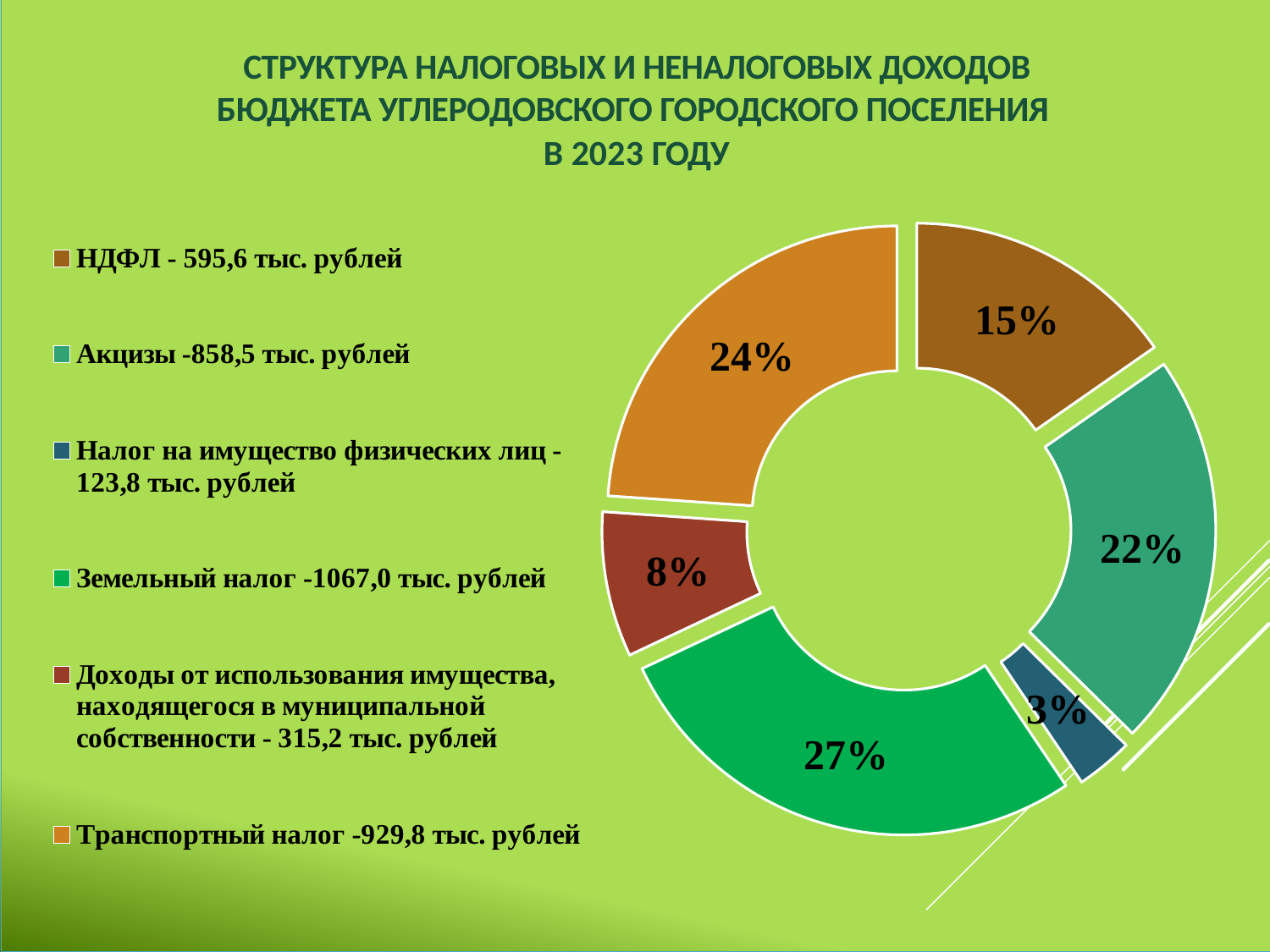
What share of the chart does Акцизы represent? 22% What share of the chart does Земельный налог represent? 27% What share of the chart does Транспортный налог represent? 24% Which category has the smallest share of the chart? Налог на имущество физических лиц Which category has the largest share of the chart? Земельный налог Which has a larger share: Акцизы or НДФЛ? Акцизы What is the difference in percentage points between the shares of Земельный налог and Транспортный налог? 3 percentage points According to the legend, what is the amount for Земельный налог? 1067,0 тыс. рублей What colour is the slice for Доходы от использования имущества, находящегося в муниципальной собственности? Red-brown What kind of chart is shown on the slide? Doughnut (pie) chart How many categories does the legend list? 6